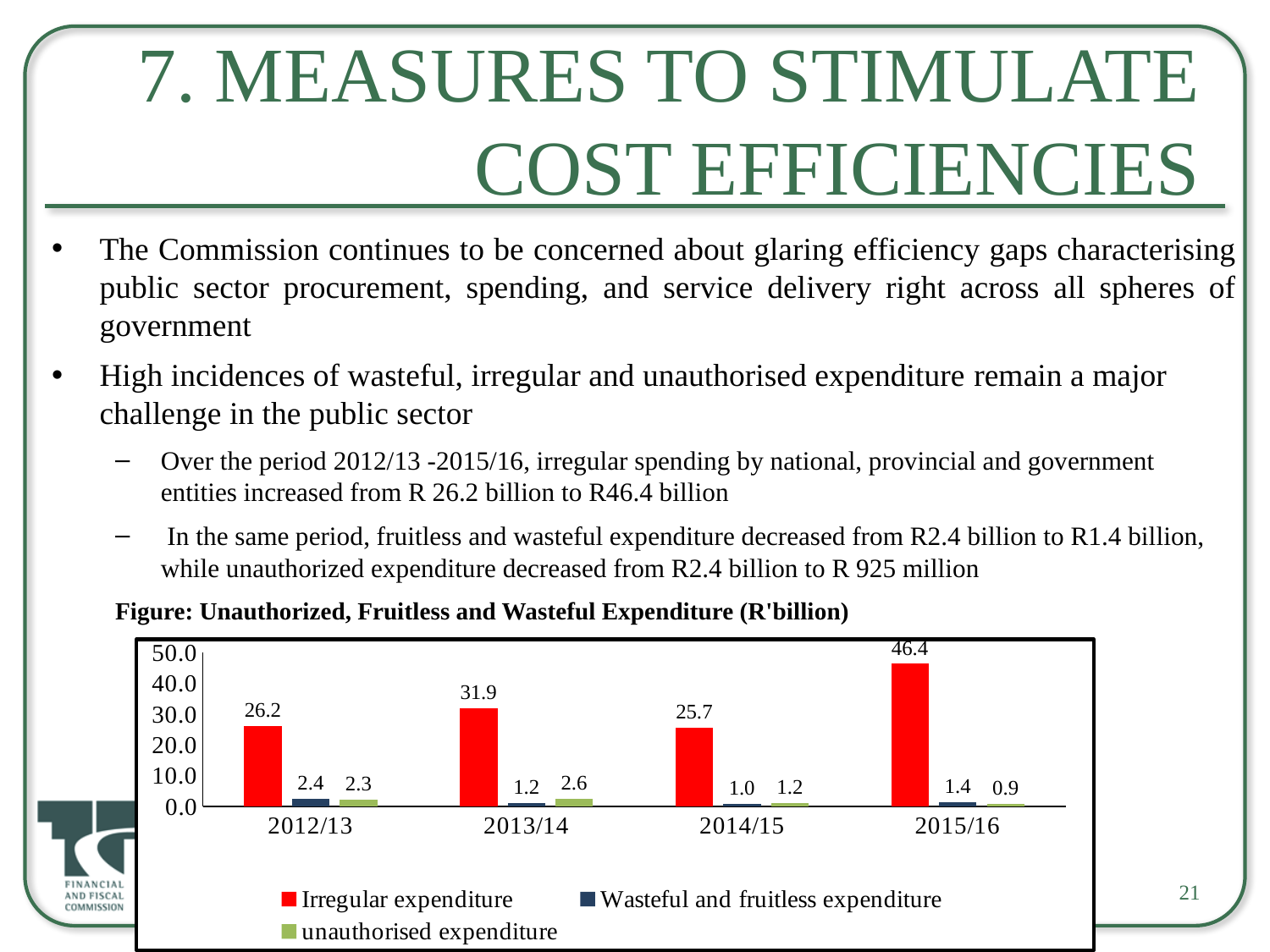
How many years are shown on the x axis? 4 Which is larger in 2013/14: Wasteful and fruitless expenditure or unauthorised expenditure? unauthorised expenditure What is the difference between Irregular expenditure in 2015/16 and 2012/13? 20.2 What kind of chart is shown? Bar chart Is the value of Irregular expenditure for 2013/14 greater or less than 30.0? greater What is the value of Irregular expenditure for 2015/16? 46.4 In which year is Irregular expenditure highest? 2015/16 In which year is Irregular expenditure lowest? 2014/15 What is the value of unauthorised expenditure for 2012/13? 2.3 How many series does the legend list? 3 What colour represents Irregular expenditure in the chart? Red What is the value of Wasteful and fruitless expenditure for 2013/14? 1.2